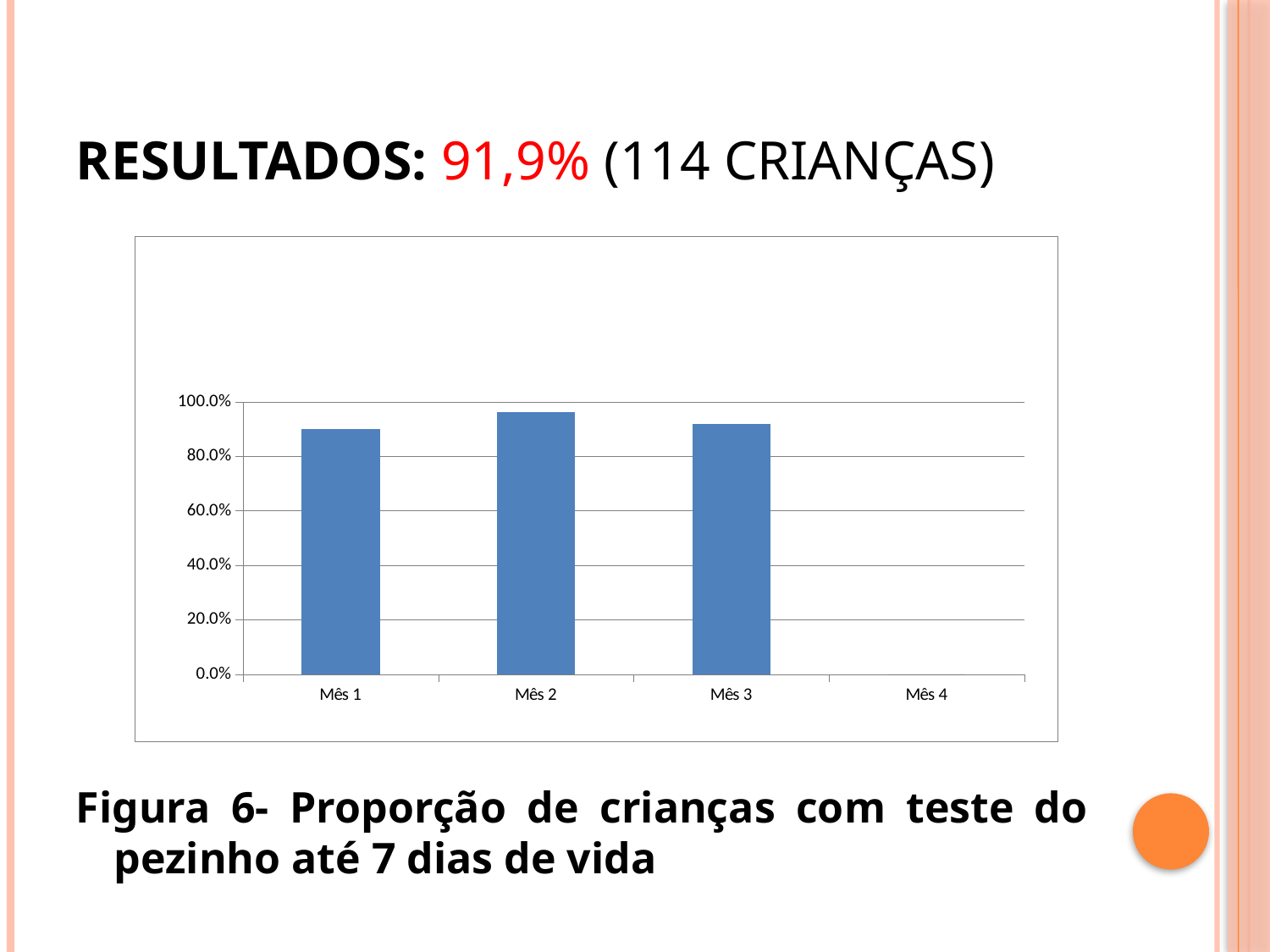
Which category on the x axis has no visible bar? Mês 4 Is the value for Mês 2 greater or less than 80.0%? greater What is the highest value shown on the y axis of the chart? 100.0% Which month has the highest bar in the chart? Mês 2 How many categories are shown on the x axis of the chart? 4 What kind of chart is shown on the slide? bar chart Which is larger, the value for Mês 2 or the value for Mês 3? Mês 2 Is the value for Mês 3 greater or less than 80.0%? greater Which is larger, the value for Mês 1 or the value for Mês 2? Mês 2 Is the value for Mês 2 greater or less than 100.0%? less